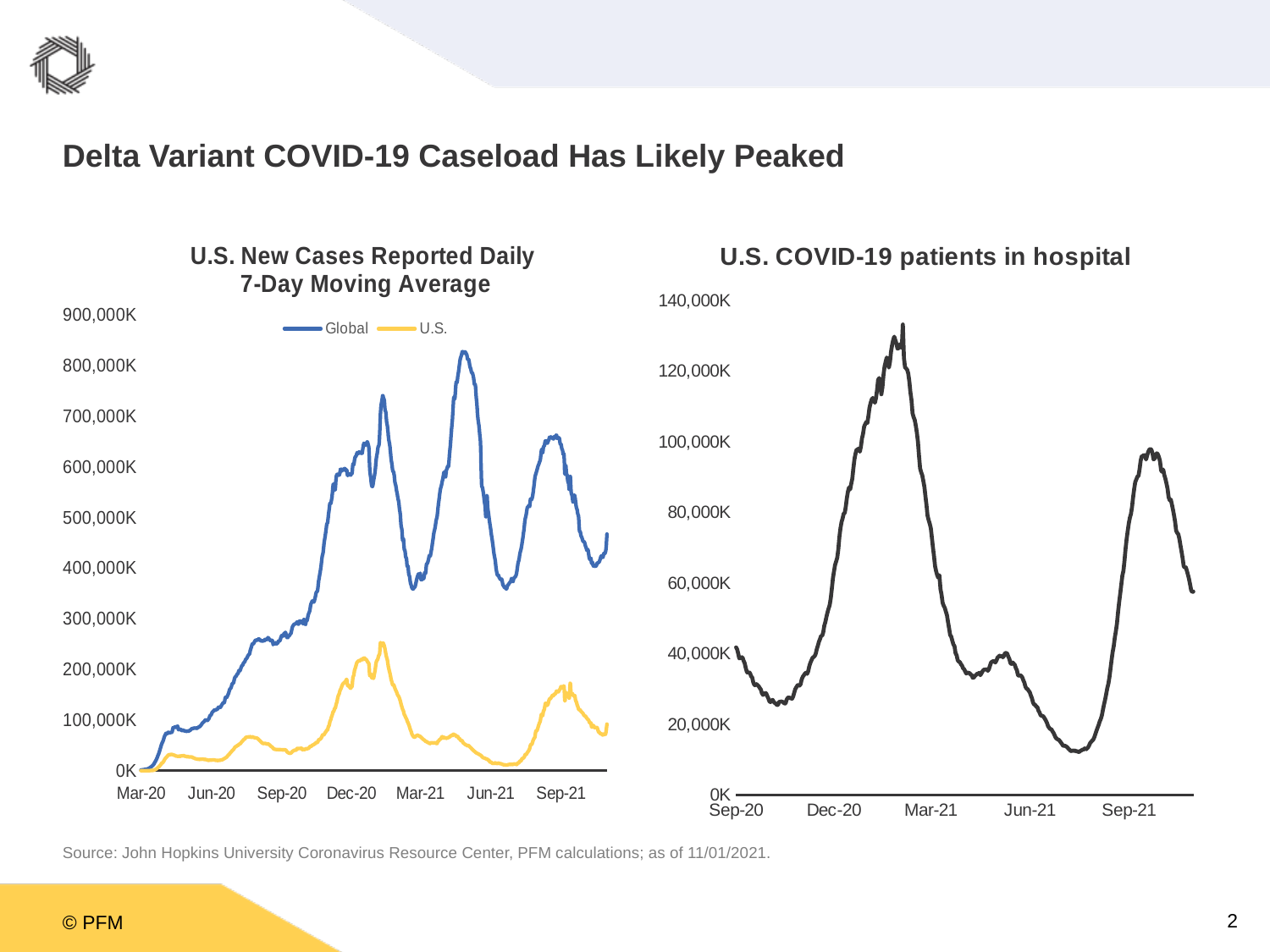
In the 'U.S. New Cases Reported Daily 7-Day Moving Average' chart, which series reaches the higher peak, Global or U.S.? Global In the 'U.S. New Cases Reported Daily 7-Day Moving Average' chart, which series is plotted in blue? Global In the 'U.S. COVID-19 patients in hospital' chart, does the line rise or fall between Sep-20 and Jan-21? rise In the 'U.S. New Cases Reported Daily 7-Day Moving Average' chart, does the Global series rise or fall between Mar-20 and Dec-20? rise What kind of chart is the 'U.S. New Cases Reported Daily 7-Day Moving Average' chart? line chart What is the first date label on the x axis of the 'U.S. COVID-19 patients in hospital' chart? Sep-20 How many series does the legend of the 'U.S. New Cases Reported Daily 7-Day Moving Average' chart list? 2 What kind of chart is the 'U.S. COVID-19 patients in hospital' chart? line chart In the 'U.S. COVID-19 patients in hospital' chart, is the highest value greater or less than 120,000K? greater In the 'U.S. COVID-19 patients in hospital' chart, is the lowest value, reached around Jun-21, greater or less than 20,000K? less In the 'U.S. New Cases Reported Daily 7-Day Moving Average' chart, is the highest value of the U.S. series greater or less than 200,000K? greater